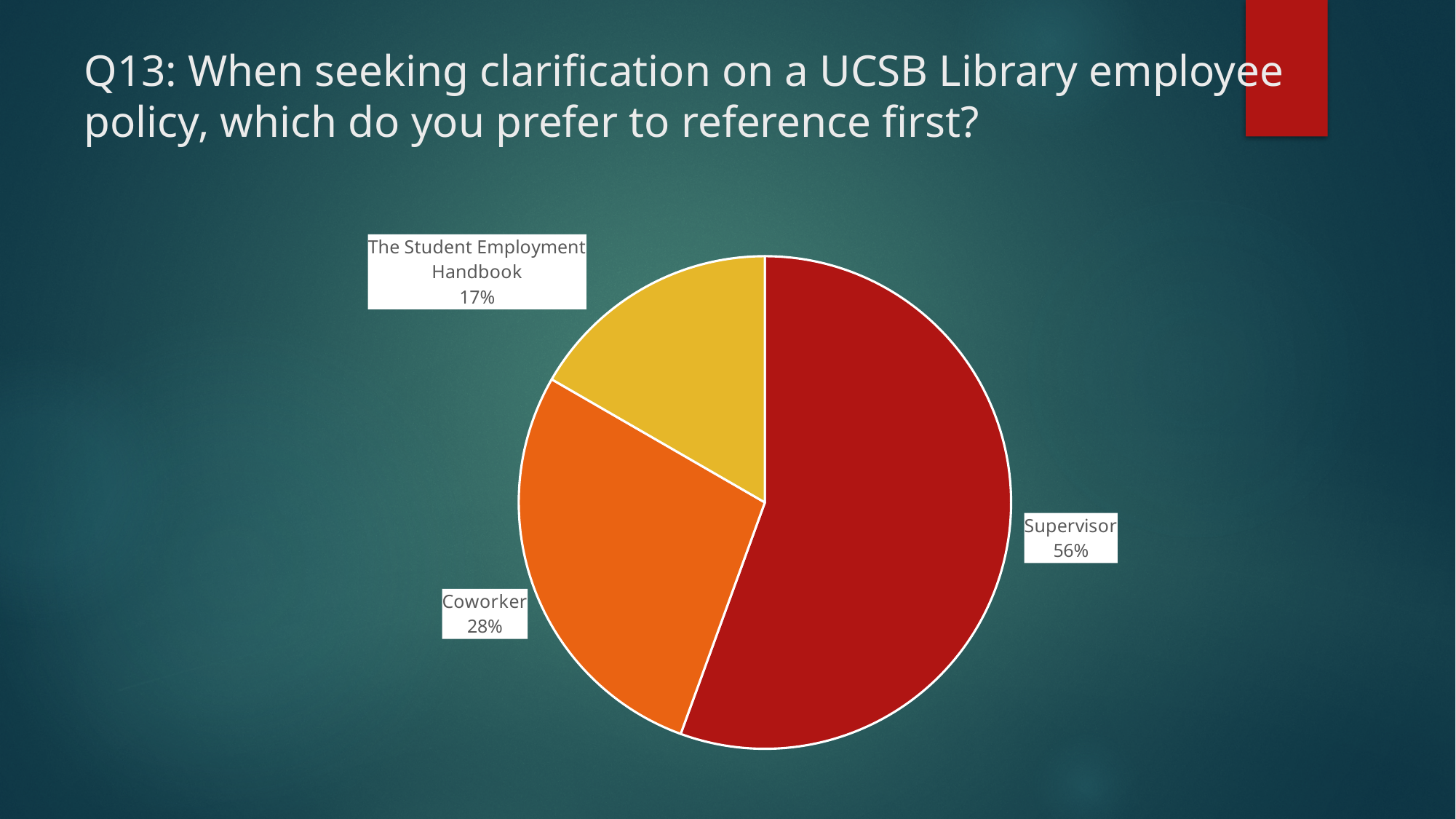
Which option has the smallest share of the pie? The Student Employment Handbook What percentage of respondents prefer to reference their Supervisor first? 56% What percentage of respondents prefer to reference a Coworker first? 28% What is the difference in percentage points between Coworker and The Student Employment Handbook? 11 How many slices does the pie chart have? 3 What type of chart is shown on the slide? Pie chart Which option has the largest share of the pie? Supervisor What colour is the Coworker slice? Orange What colour is the Supervisor slice? Red Which is larger, the share for Coworker or the share for The Student Employment Handbook? Coworker What is the difference in percentage points between Supervisor and Coworker? 28 What percentage of respondents prefer to reference The Student Employment Handbook first? 17%